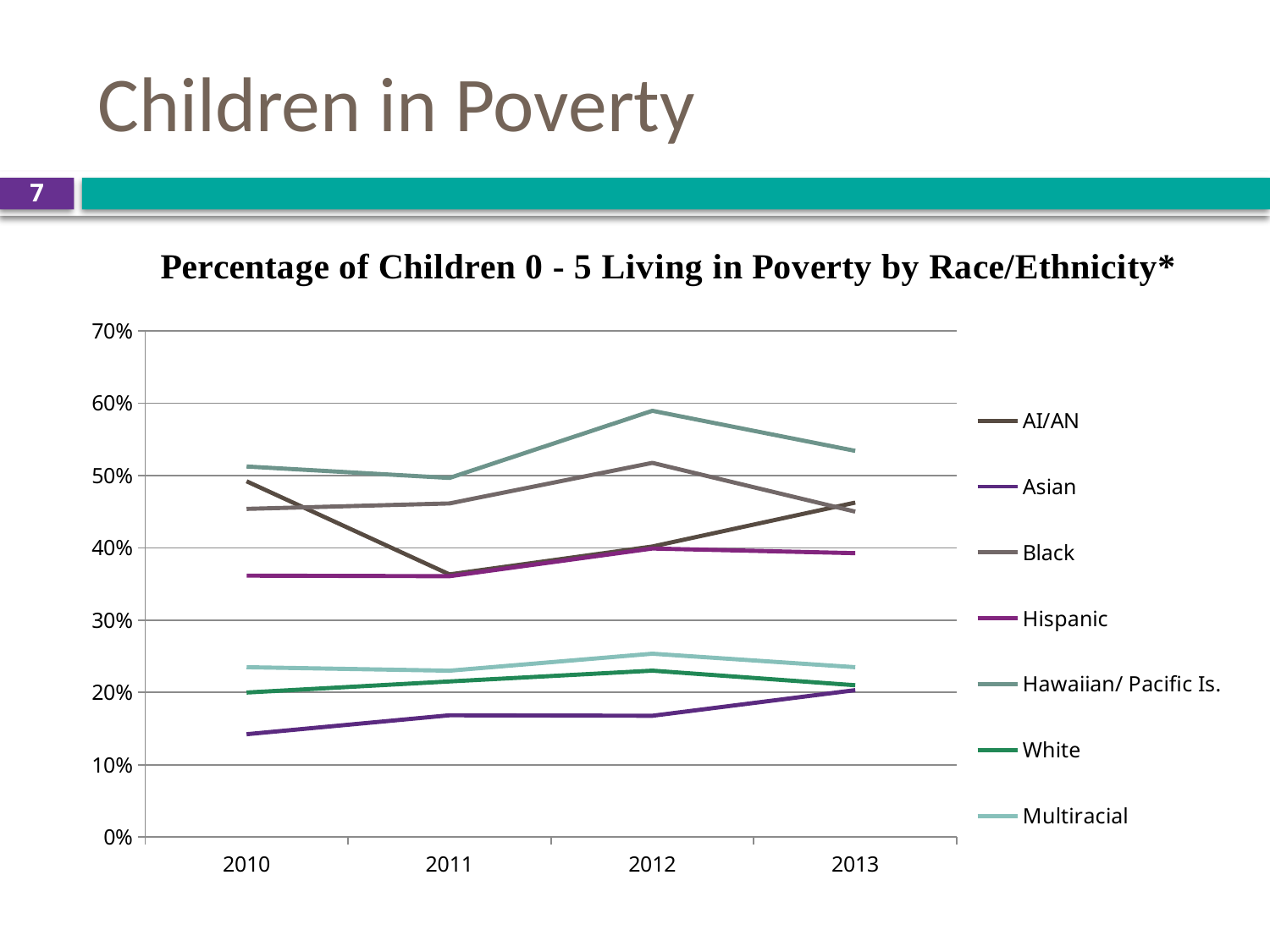
What kind of chart is shown on the slide? line chart What is the title of the chart? Percentage of Children 0 - 5 Living in Poverty by Race/Ethnicity* Which race/ethnicity group has the highest value in 2012? Hawaiian/ Pacific Is. Which race/ethnicity group has the lowest value in 2010? Asian In 2010, which is larger: the value for AI/AN or the value for Black? AI/AN Is the value for Asian in 2010 greater or less than 20%? less How many series does the legend list? 7 Does the Asian line rise or fall from 2010 to 2013? rise Is the value for Hawaiian/ Pacific Is. in 2012 greater or less than 50%? greater How many years are shown on the x axis? 4 In 2013, which is larger: the value for Hawaiian/ Pacific Is. or the value for Black? Hawaiian/ Pacific Is. Is the value for AI/AN in 2011 greater or less than 40%? less